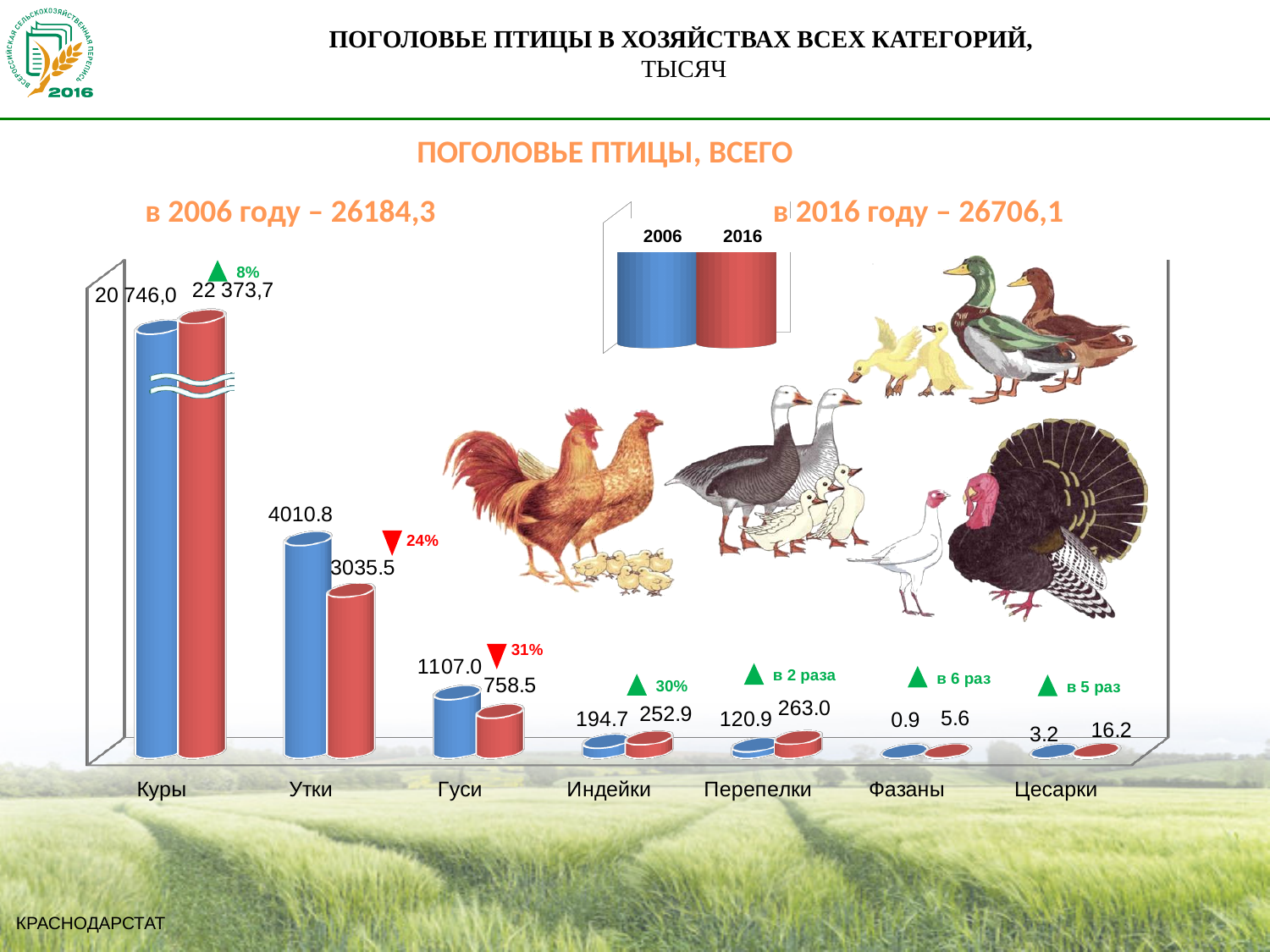
What is the value for Перепелки in 2016? 263.0 What is the value for Гуси in 2016? 758.5 What is the value for Утки in 2006? 4010.8 What is the difference between the 2006 and 2016 values for Утки? 975.3 How many series does the legend list? 2 Which is larger for Индейки: the 2006 value or the 2016 value? 2016 Which category has the highest value in 2016? Куры Which colour represents the 2016 series in the legend? red Which category has the lowest value in 2006? Фазаны What is the value for Фазаны in 2006? 0.9 How many categories are shown on the x axis? 7 What kind of chart is shown on the slide? bar chart